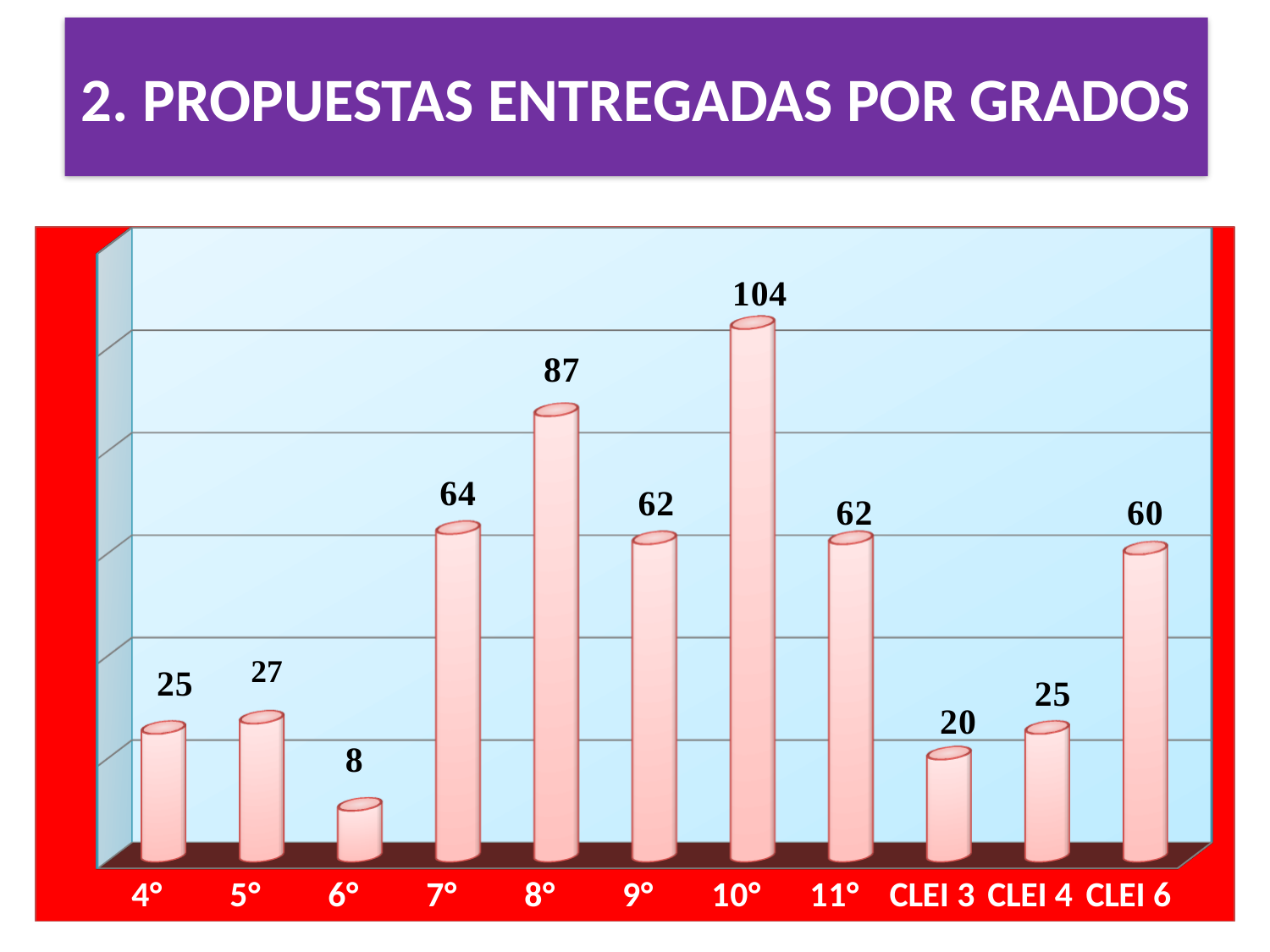
Which is larger, the value for 8° or the value for 9°? 8° Which grade has the lowest number of proposals? 6° Which is larger, the value for 5° or the value for CLEI 4? 5° What kind of chart is shown on the slide? bar chart What is the value for CLEI 6? 60 How many categories are shown on the x axis? 11 What is the difference between the values for 7° and CLEI 3? 44 What is the difference between the values for 10° and 8°? 17 Which grade has the highest number of proposals? 10° What is the title of the slide? 2. PROPUESTAS ENTREGADAS POR GRADOS What is the value for 10°? 104 What is the value for 6°? 8